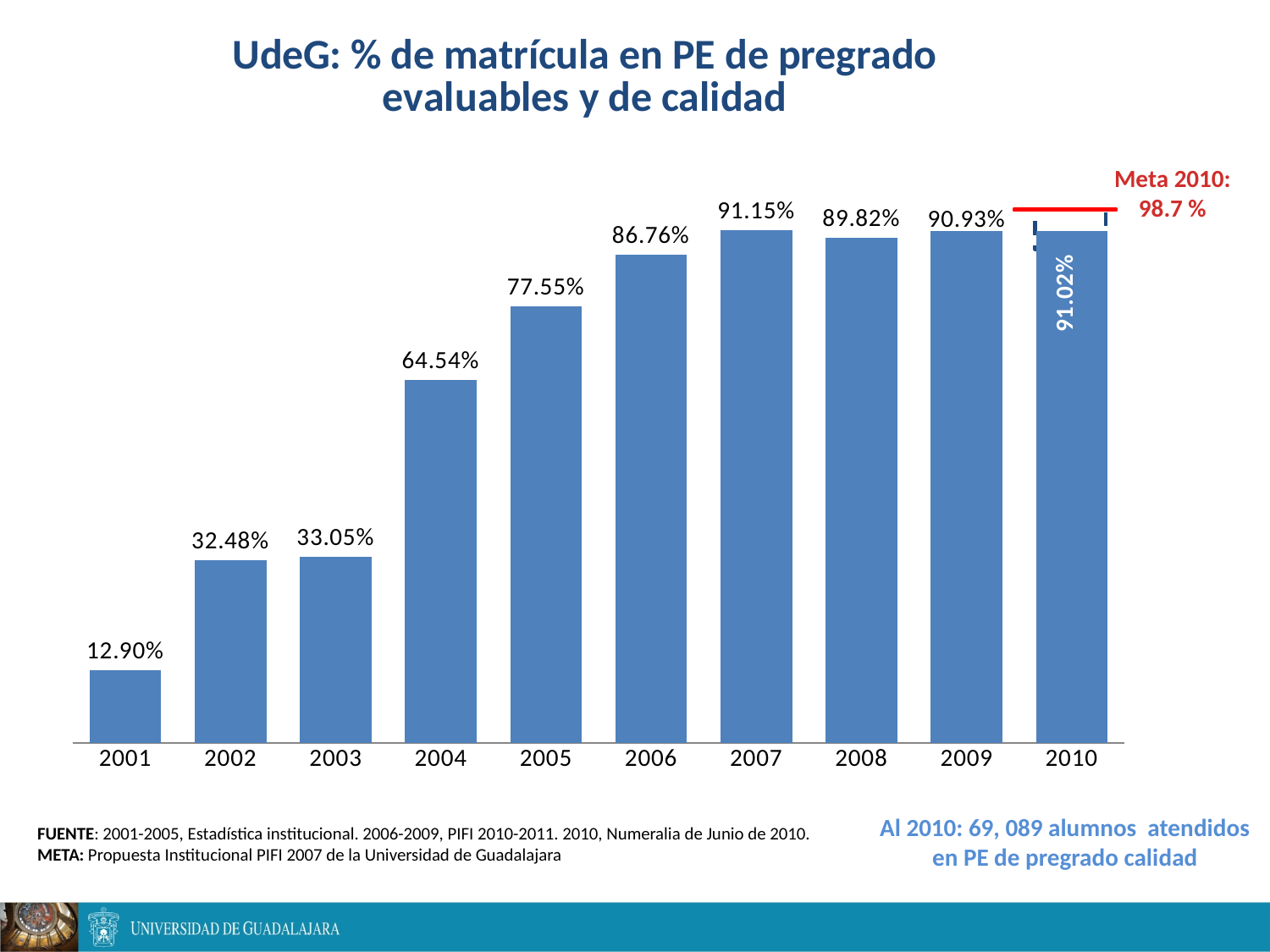
Which year has the lowest value? 2001 Which is larger, the value for 2005 or the value for 2004? 2005 What kind of chart is this? Bar chart How many years are shown on the x axis? 10 What is the difference between the values for 2010 and 2001? 78.12 percentage points What is the difference between the values for 2007 and 2008? 1.33 percentage points What is the target (Meta) value shown for 2010? 98.7 % What is the value for 2001? 12.90% What is the value for 2010? 91.02% What is the value for 2006? 86.76% What is the value for 2004? 64.54% Which year has the highest value? 2007